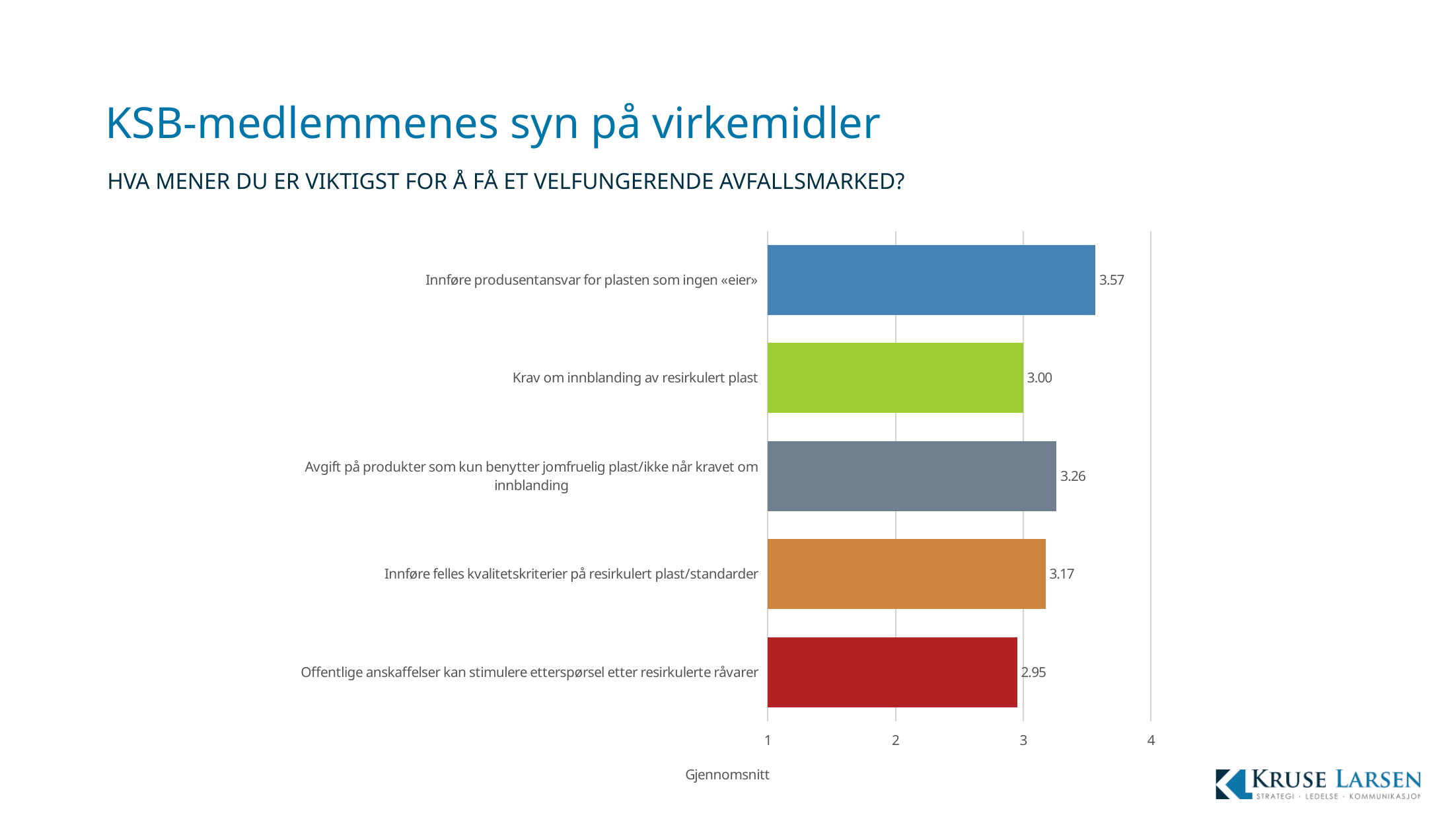
What is the value for "Offentlige anskaffelser kan stimulere etterspørsel etter resirkulerte råvarer"? 2.95 What is the value for "Krav om innblanding av resirkulert plast"? 3.00 Which is larger: the value for "Avgift på produkter som kun benytter jomfruelig plast/ikke når kravet om innblanding" or for "Innføre felles kvalitetskriterier på resirkulert plast/standarder"? Avgift på produkter som kun benytter jomfruelig plast/ikke når kravet om innblanding Which category has the lowest value? Offentlige anskaffelser kan stimulere etterspørsel etter resirkulerte råvarer Is the value for "Innføre felles kvalitetskriterier på resirkulert plast/standarder" greater or less than 3? greater What is the difference between the values for "Avgift på produkter som kun benytter jomfruelig plast/ikke når kravet om innblanding" and "Innføre felles kvalitetskriterier på resirkulert plast/standarder"? 0.09 How many categories are shown in the chart? 5 Which category has the highest value? Innføre produsentansvar for plasten som ingen «eier» What kind of chart is shown on the slide? Bar chart What is the difference between the values for "Innføre produsentansvar for plasten som ingen «eier»" and "Krav om innblanding av resirkulert plast"? 0.57 What is the label on the horizontal axis of the chart? Gjennomsnitt What is the value for "Innføre produsentansvar for plasten som ingen «eier»"? 3.57